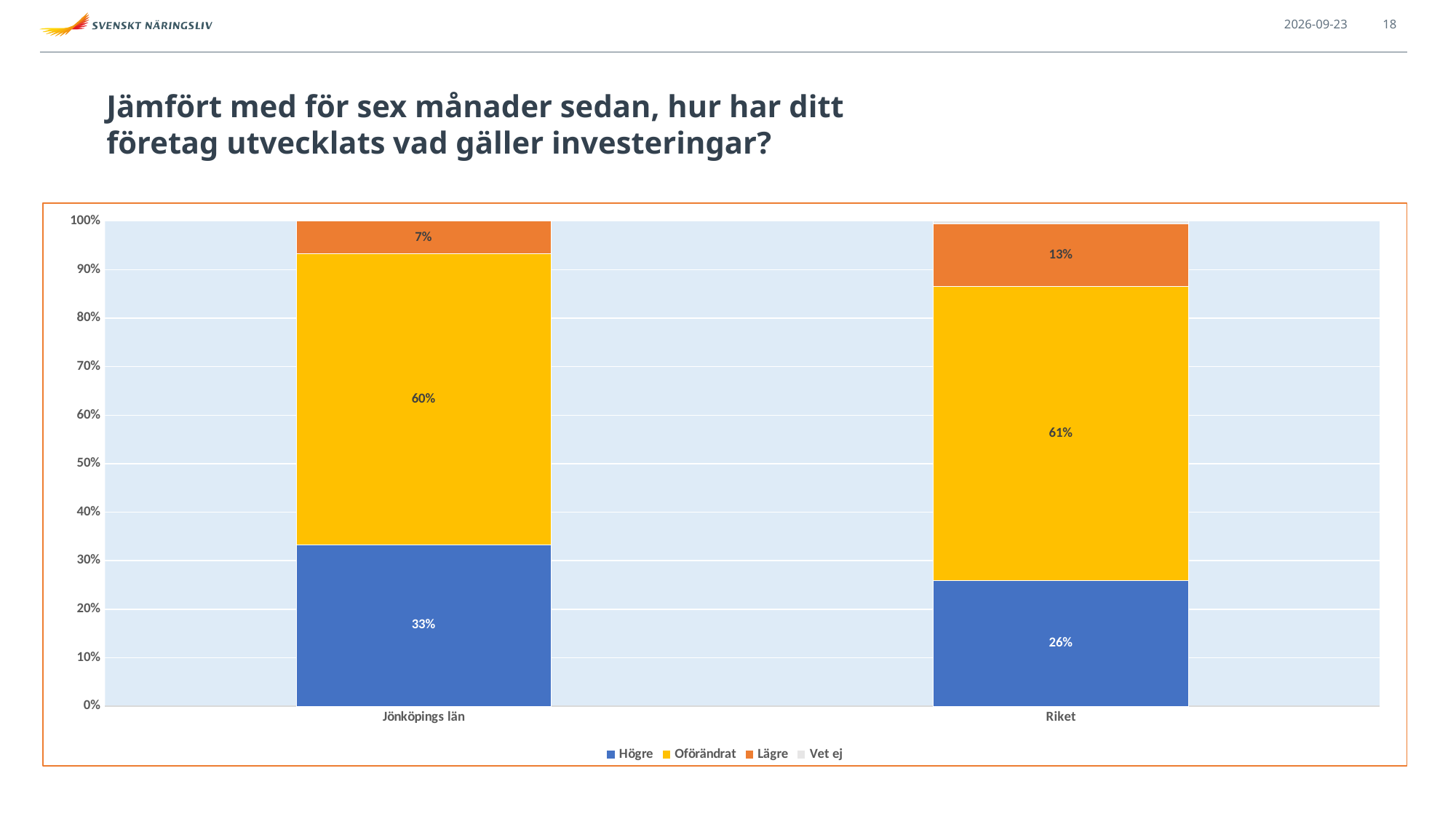
What is the difference between the Lägre value for Riket and the Lägre value for Jönköpings län? 6 percentage points How many categories are shown on the x axis? 2 What is the value for Lägre for Riket? 13% What is the difference between the Högre value for Jönköpings län and the Högre value for Riket? 7 percentage points Which response has the largest share in the Riket bar? Oförändrat What is the value for Högre for Jönköpings län? 33% What kind of chart is shown on the slide? Stacked bar chart How many series does the legend list? 4 What is the value for Lägre for Jönköpings län? 7% What is the value for Oförändrat for Riket? 61% Which labelled response has the smallest share in the Jönköpings län bar? Lägre Which category has the larger Högre share, Jönköpings län or Riket? Jönköpings län